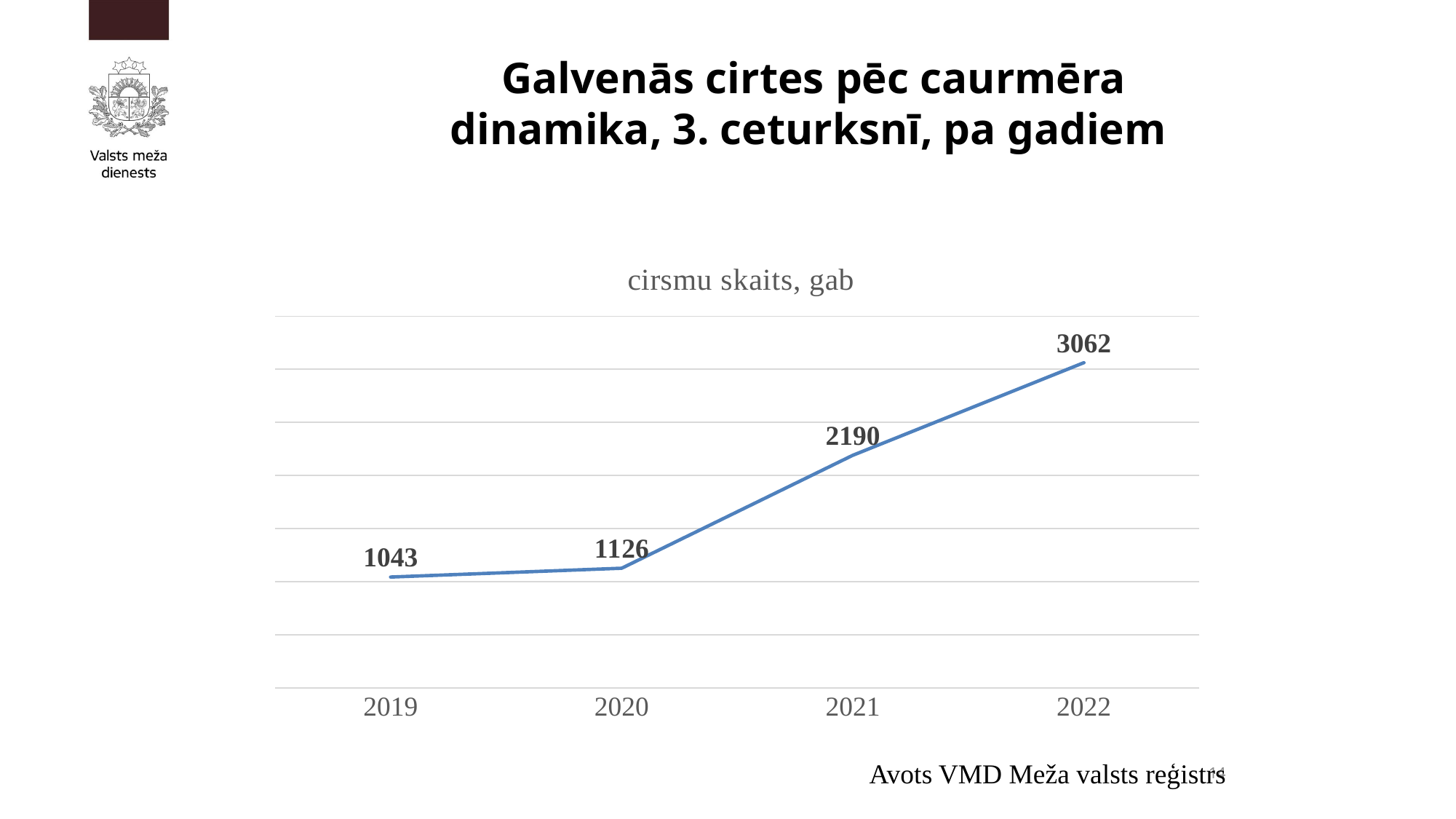
What is the difference between the values for 2020 and 2019? 83 What is the value for 2019? 1043 Which year has the lowest value? 2019 Do the values rise or fall from 2019 to 2022? rise Which is larger, the value for 2021 or the value for 2020? 2021 What kind of chart is shown on the slide? line chart What is the value for 2022? 3062 How many years are plotted on the chart? 4 What is the value for 2020? 1126 What is the value for 2021? 2190 What is the difference between the values for 2022 and 2021? 872 Which year has the highest value? 2022